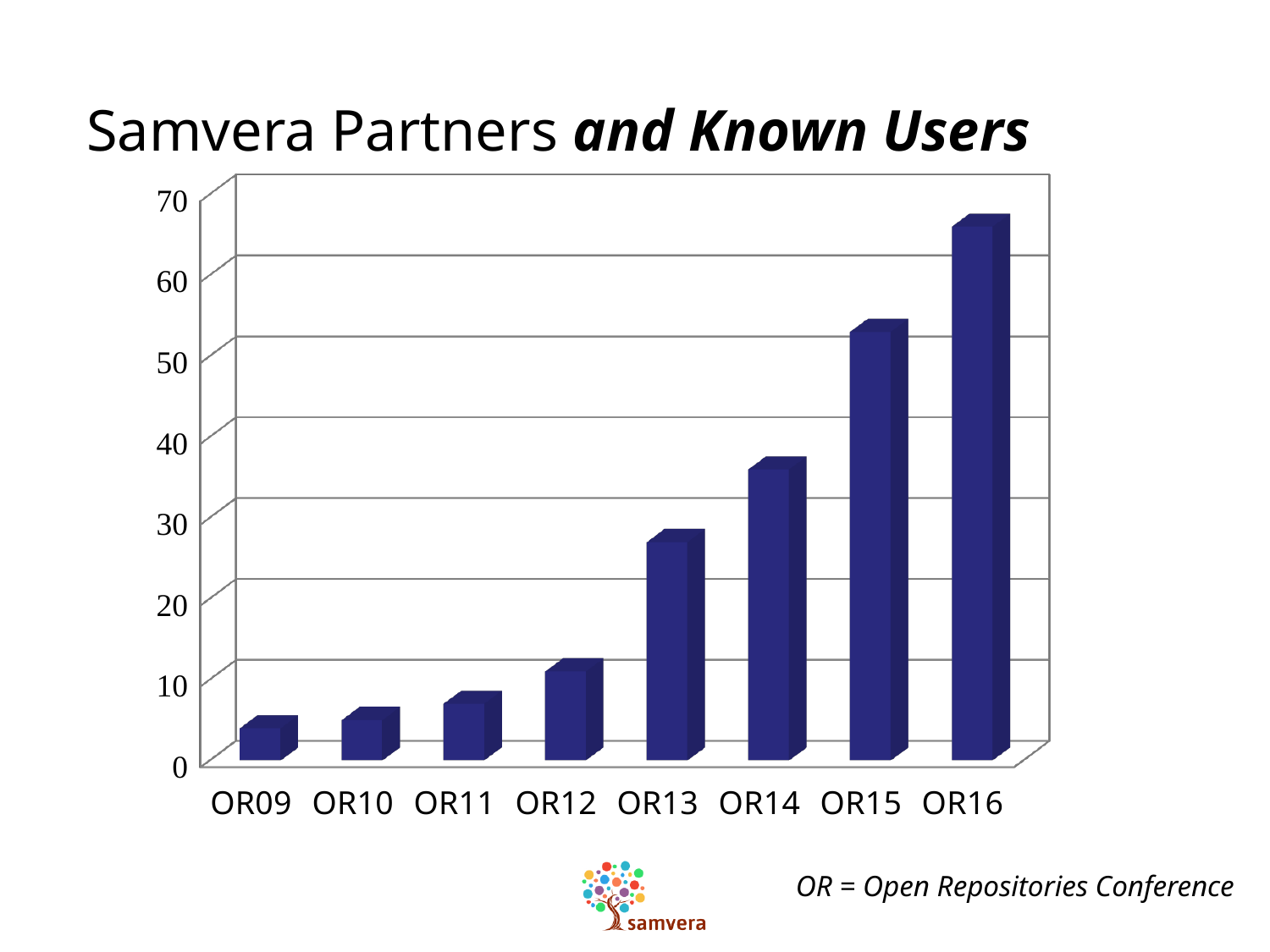
Is the value for OR14 greater or less than 30? greater Which is larger, the value for OR13 or the value for OR12? OR13 According to the note on the slide, what does OR stand for? Open Repositories Conference What kind of chart is shown on the slide? bar chart How many categories are shown on the x axis? 8 Is the value for OR09 greater or less than 10? less Which is larger, the value for OR15 or the value for OR14? OR15 Is the value for OR16 greater or less than 60? greater Which category has the highest value? OR16 Do the values rise or fall from OR09 to OR16? rise